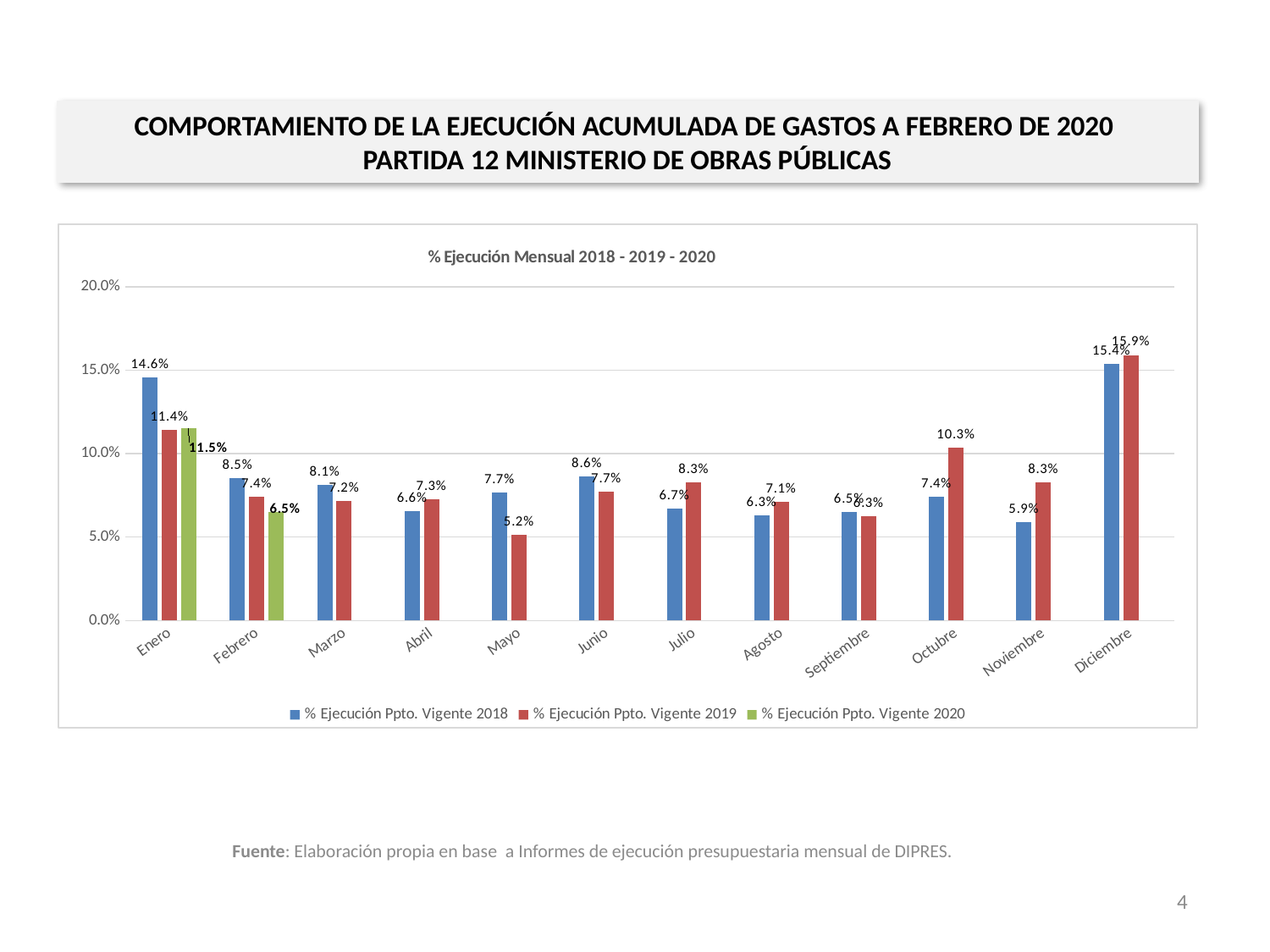
Which month has the highest value for % Ejecución Ppto. Vigente 2019? Diciembre How many months are shown on the x axis? 12 What is the value of % Ejecución Ppto. Vigente 2018 for Enero? 14.6% What kind of chart is shown on the slide? Bar chart Which month has the lowest value for % Ejecución Ppto. Vigente 2018? Noviembre What is the value of % Ejecución Ppto. Vigente 2020 for Febrero? 6.5% What is the value of % Ejecución Ppto. Vigente 2019 for Octubre? 10.3% Is the 2019 value for Diciembre greater or less than 15.0%? greater What is the title of the chart? % Ejecución Mensual 2018 - 2019 - 2020 What is the difference between the 2018 and 2019 values for Mayo? 2.5% How many series does the legend list? 3 Which is larger for Julio: the 2018 value or the 2019 value? 2019